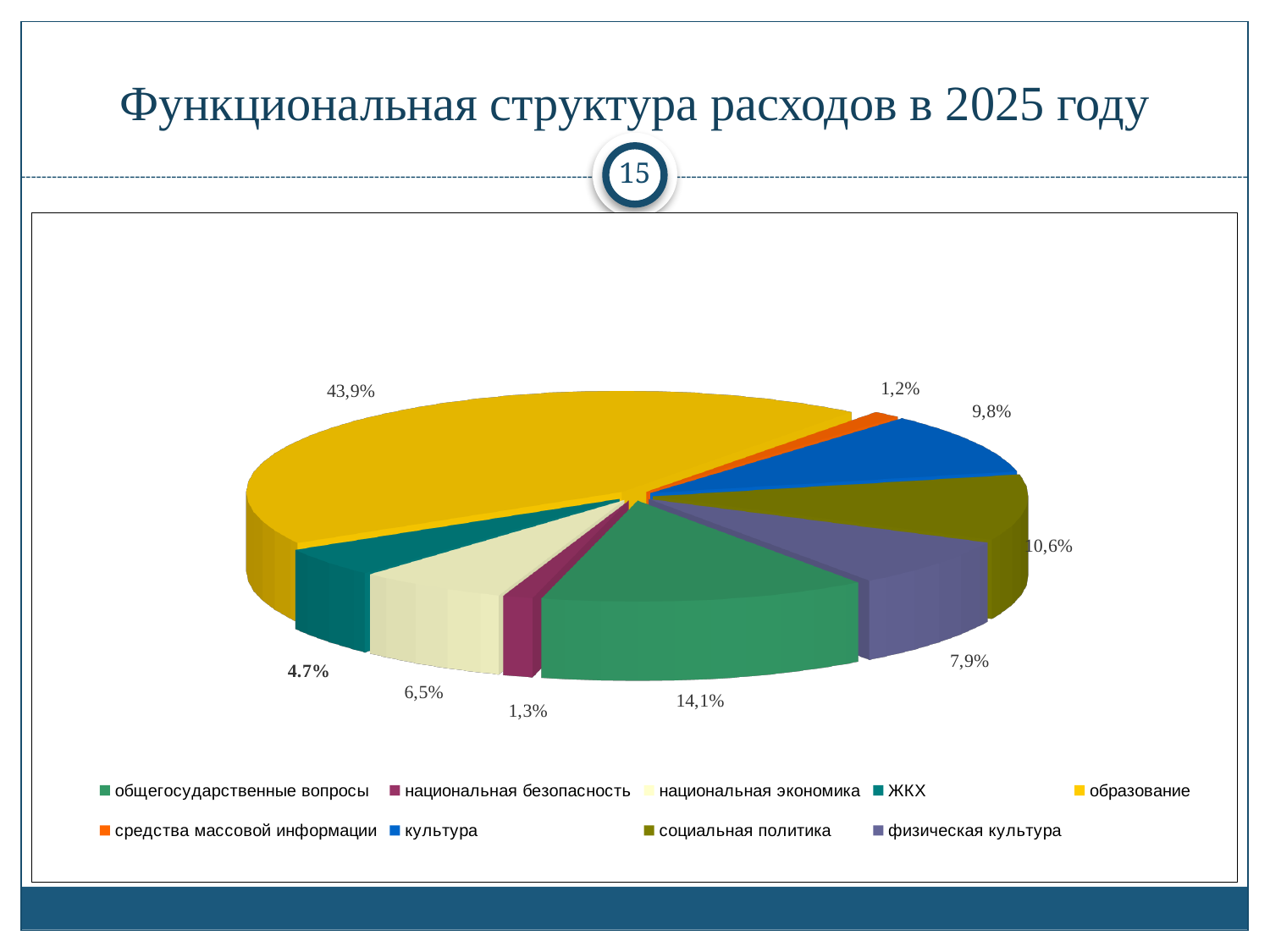
Which has a larger share: социальная политика or физическая культура? социальная политика How many categories does the legend list? 9 What is the difference between the shares of образование and общегосударственные вопросы? 29,8% What share of expenditures goes to культура? 9,8% What share of expenditures goes to образование? 43,9% Which category has the largest share of expenditures? образование What share of expenditures goes to ЖКХ? 4.7% What is the title of the slide? Функциональная структура расходов в 2025 году What share of expenditures goes to общегосударственные вопросы? 14,1% What share of expenditures goes to социальная политика? 10,6% Which category has the smallest share of expenditures? средства массовой информации What kind of chart is shown on the slide? pie chart